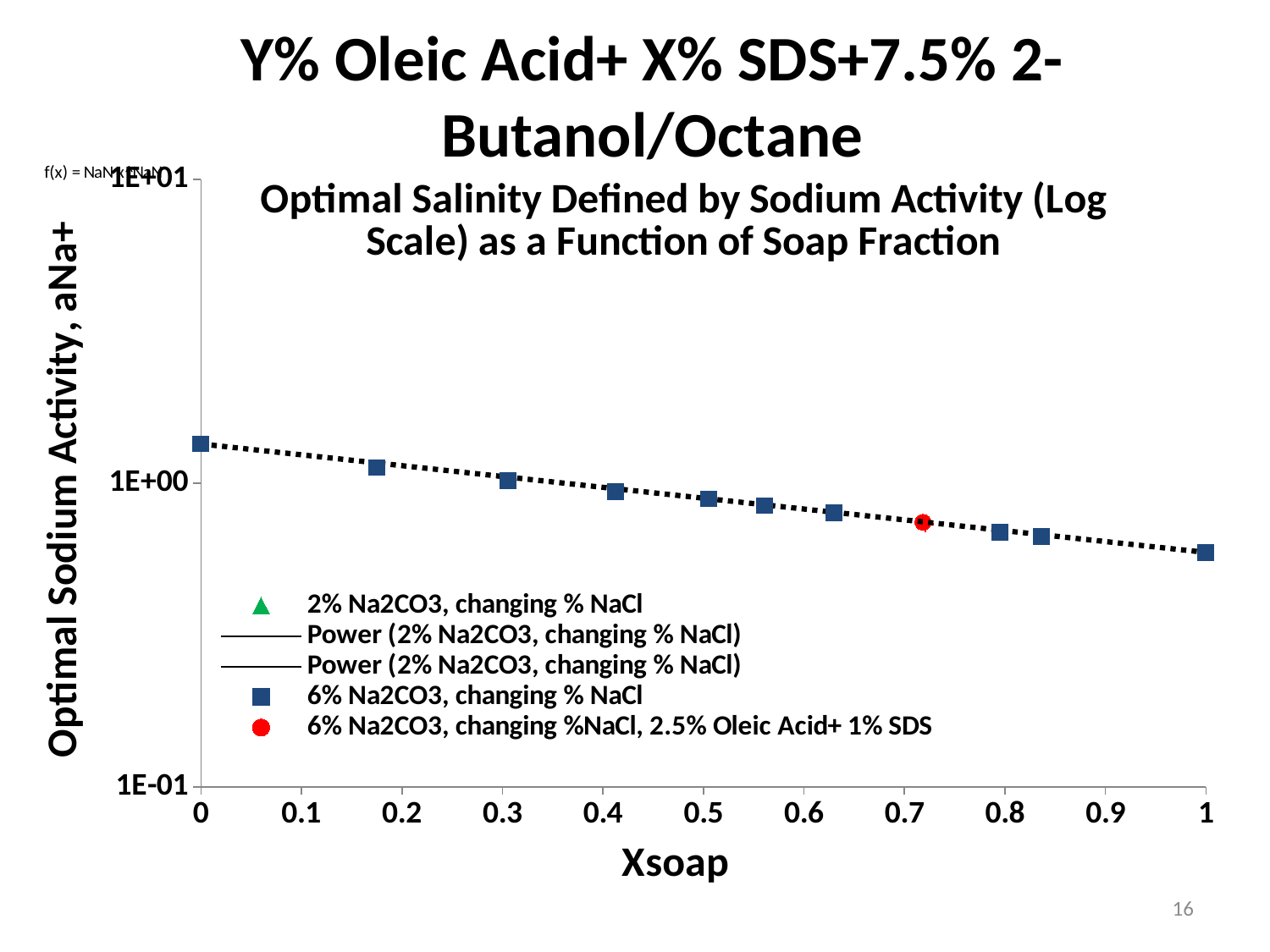
How many points are plotted for the 6% Na2CO3, changing %NaCl, 2.5% Oleic Acid+ 1% SDS series? 1 What kind of chart is shown on the slide? scatter chart At which Xsoap value does the 6% Na2CO3, changing % NaCl series reach its highest value? 0 Which is larger for the 6% Na2CO3, changing % NaCl series: the value at Xsoap = 0 or at Xsoap = 1? Xsoap = 0 Is the value of the 6% Na2CO3, changing % NaCl series at Xsoap = 1 greater or less than 1E+00? less Do the values of the 6% Na2CO3, changing % NaCl series rise or fall as Xsoap increases? fall At which Xsoap value does the 6% Na2CO3, changing % NaCl series reach its lowest value? 1 Is the value of the 6% Na2CO3, changing % NaCl series at Xsoap = 0 greater or less than 1E+00? greater How many entries does the legend list? 5 Is the value of the red point (6% Na2CO3, changing %NaCl, 2.5% Oleic Acid+ 1% SDS) greater or less than 1E+00? less What is the title of the x axis? Xsoap What is the title of the y axis? Optimal Sodium Activity, aNa+